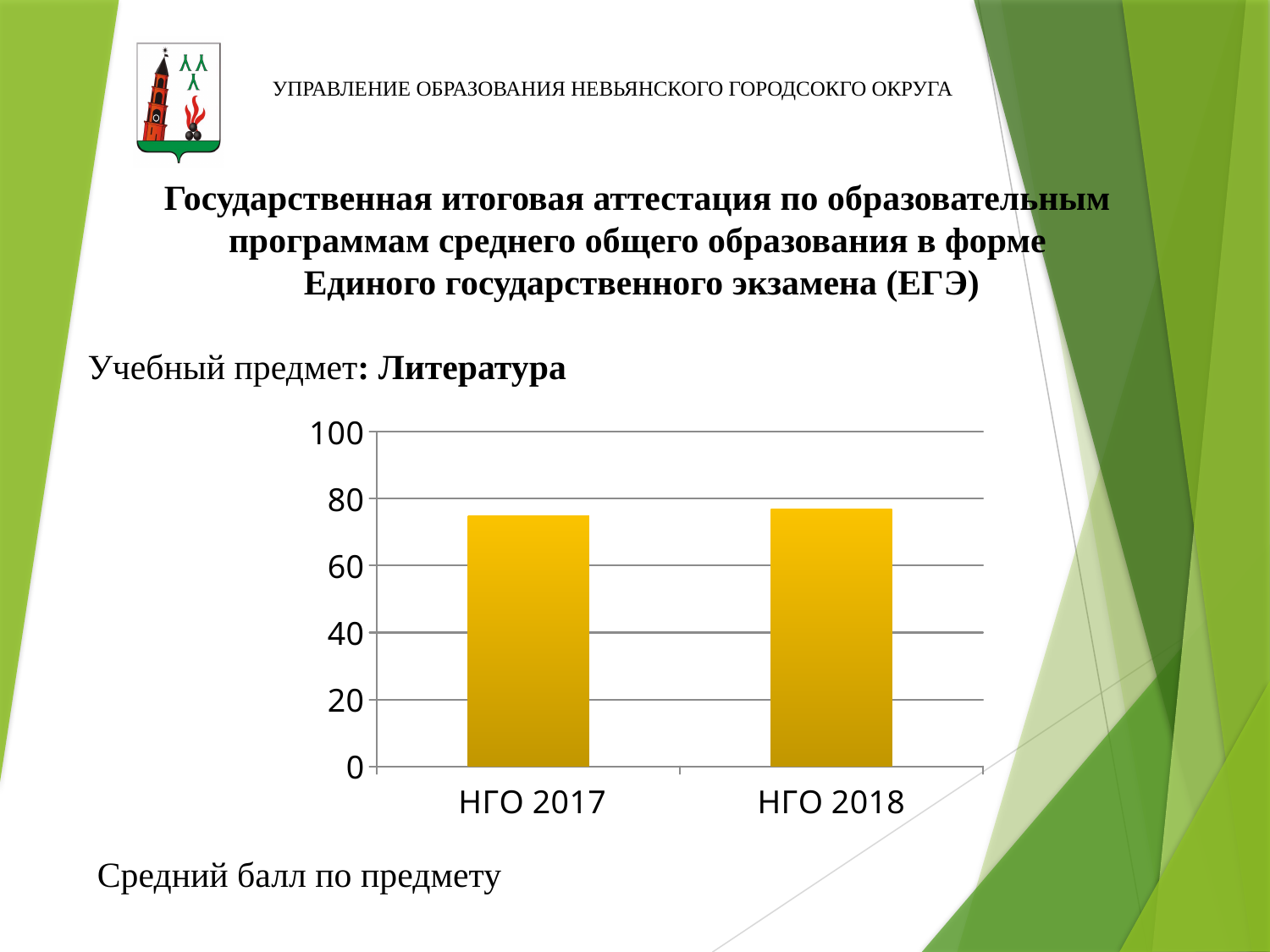
Is the value for НГО 2018 greater or less than 60? greater Is the value for НГО 2017 greater or less than 60? greater What is the highest value shown on the vertical axis of the chart? 100 Is the value for НГО 2017 greater or less than 80? less Which school subject (учебный предмет) does the chart refer to? Литература What kind of chart is shown on the slide? bar chart How many bars (categories) does the chart show? 2 What are the labels of the two categories on the horizontal axis? НГО 2017 and НГО 2018